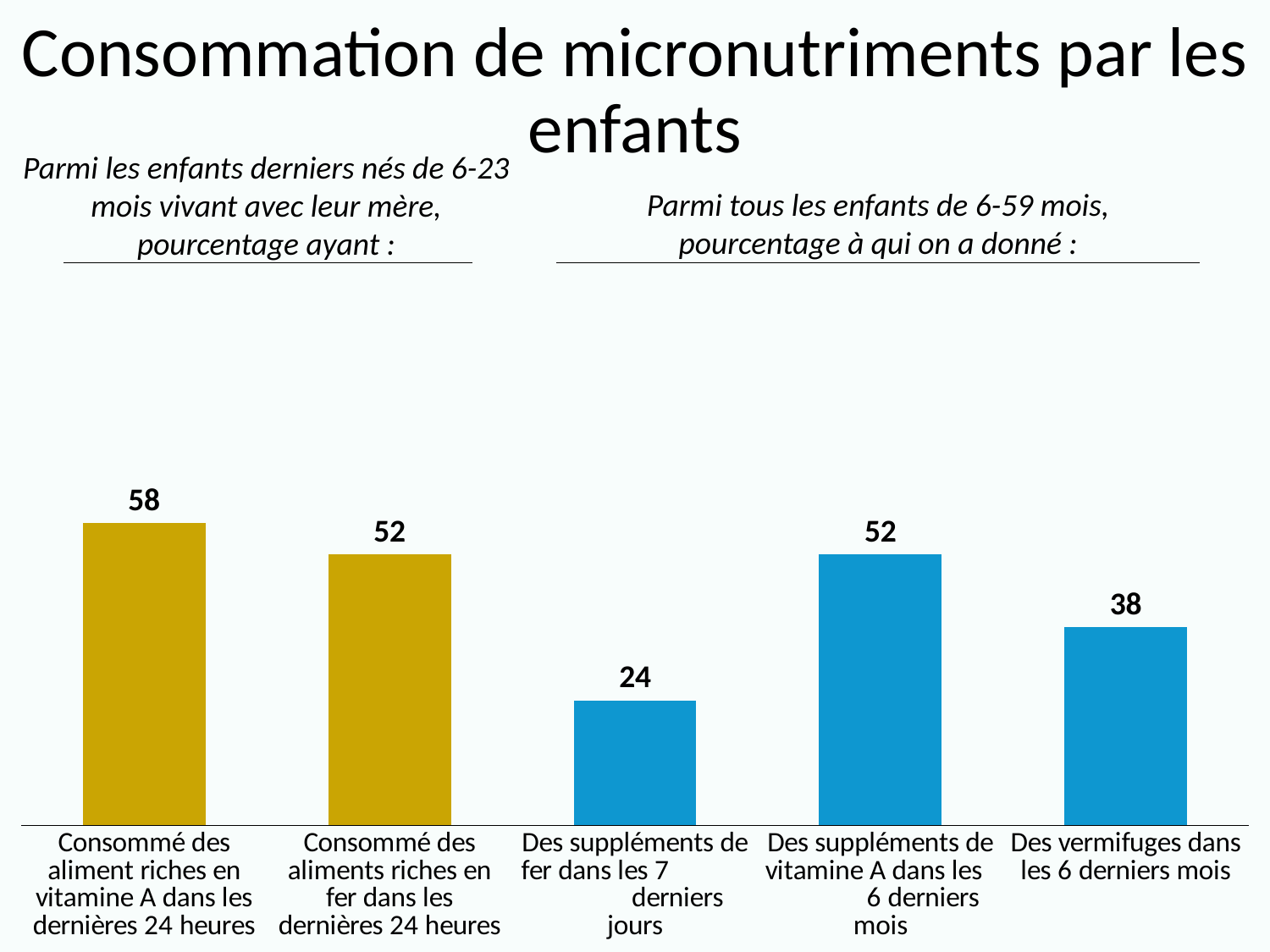
What is the value for 'Des suppléments de fer dans les 7 derniers jours'? 24 How many categories are shown in the chart? 5 Which category has the lowest value? Des suppléments de fer dans les 7 derniers jours What is the difference between the value for 'Consommé des aliment riches en vitamine A dans les dernières 24 heures' and the value for 'Des vermifuges dans les 6 derniers mois'? 20 What is the value for 'Des suppléments de vitamine A dans les 6 derniers mois'? 52 What is the value for 'Consommé des aliment riches en vitamine A dans les dernières 24 heures'? 58 What kind of chart is shown on the slide? Bar chart Which category has the highest value? Consommé des aliment riches en vitamine A dans les dernières 24 heures Which is larger: the value for 'Des vermifuges dans les 6 derniers mois' or the value for 'Des suppléments de fer dans les 7 derniers jours'? Des vermifuges dans les 6 derniers mois What is the difference between the value for 'Des suppléments de vitamine A dans les 6 derniers mois' and the value for 'Des suppléments de fer dans les 7 derniers jours'? 28 What is the value for 'Des vermifuges dans les 6 derniers mois'? 38 What is the title of the slide? Consommation de micronutriments par les enfants